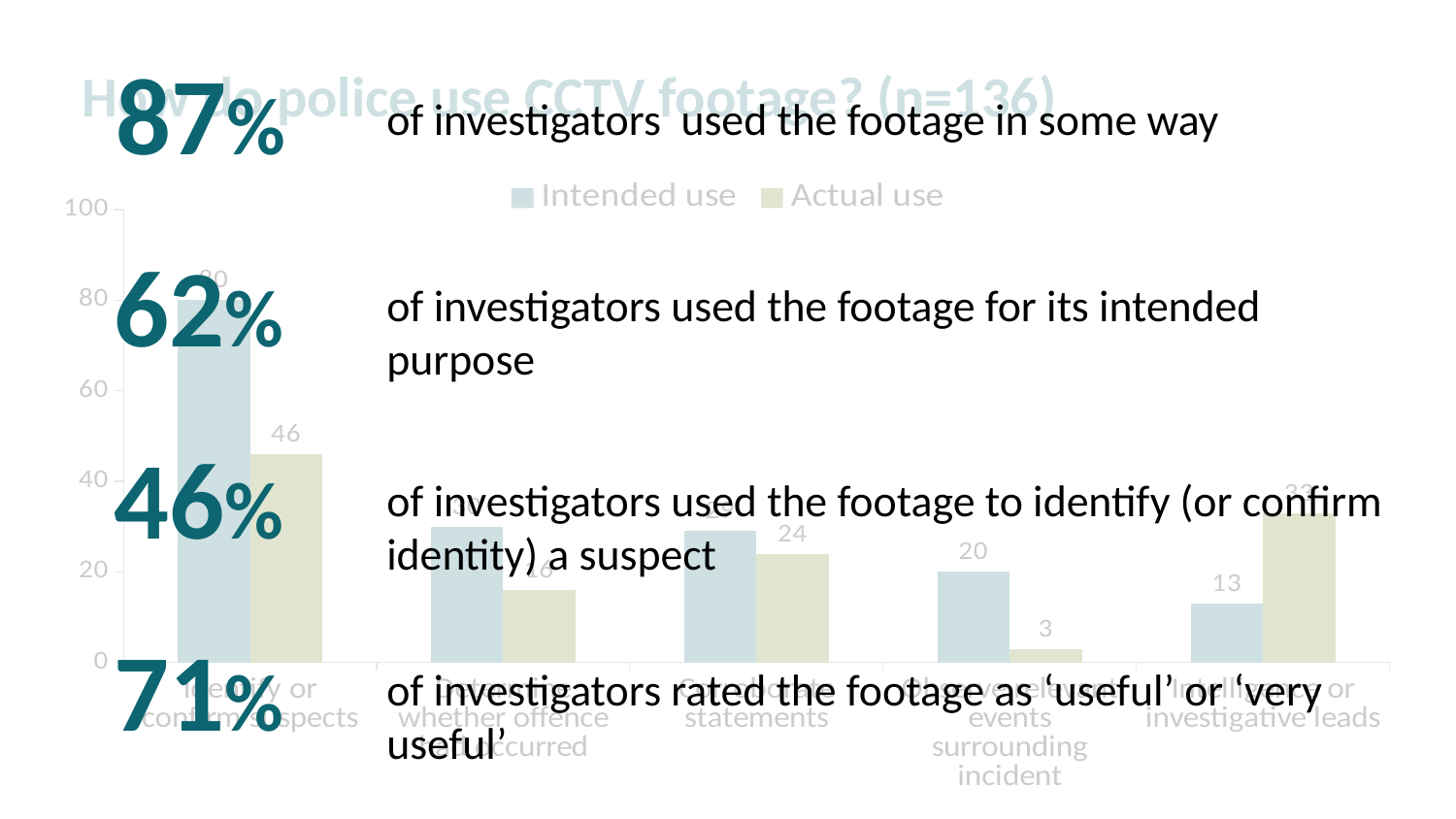
Which category has the lowest Actual use value? Observe relevant events surrounding incident What is the Intended use value for Observe relevant events surrounding incident? 20 What is the Actual use value for Identify or confirm suspects? 46 What is the Actual use value for Observe relevant events surrounding incident? 3 For Intelligence or investigative leads, which is larger: Intended use or Actual use? Actual use What is the Intended use value for Intelligence or investigative leads? 13 What kind of chart is shown on the slide? bar chart Which category has the highest Intended use value? Identify or confirm suspects How many series does the legend list? 2 What is the Actual use value for Corroborate statements? 24 What is the difference between Intended use and Actual use for Observe relevant events surrounding incident? 17